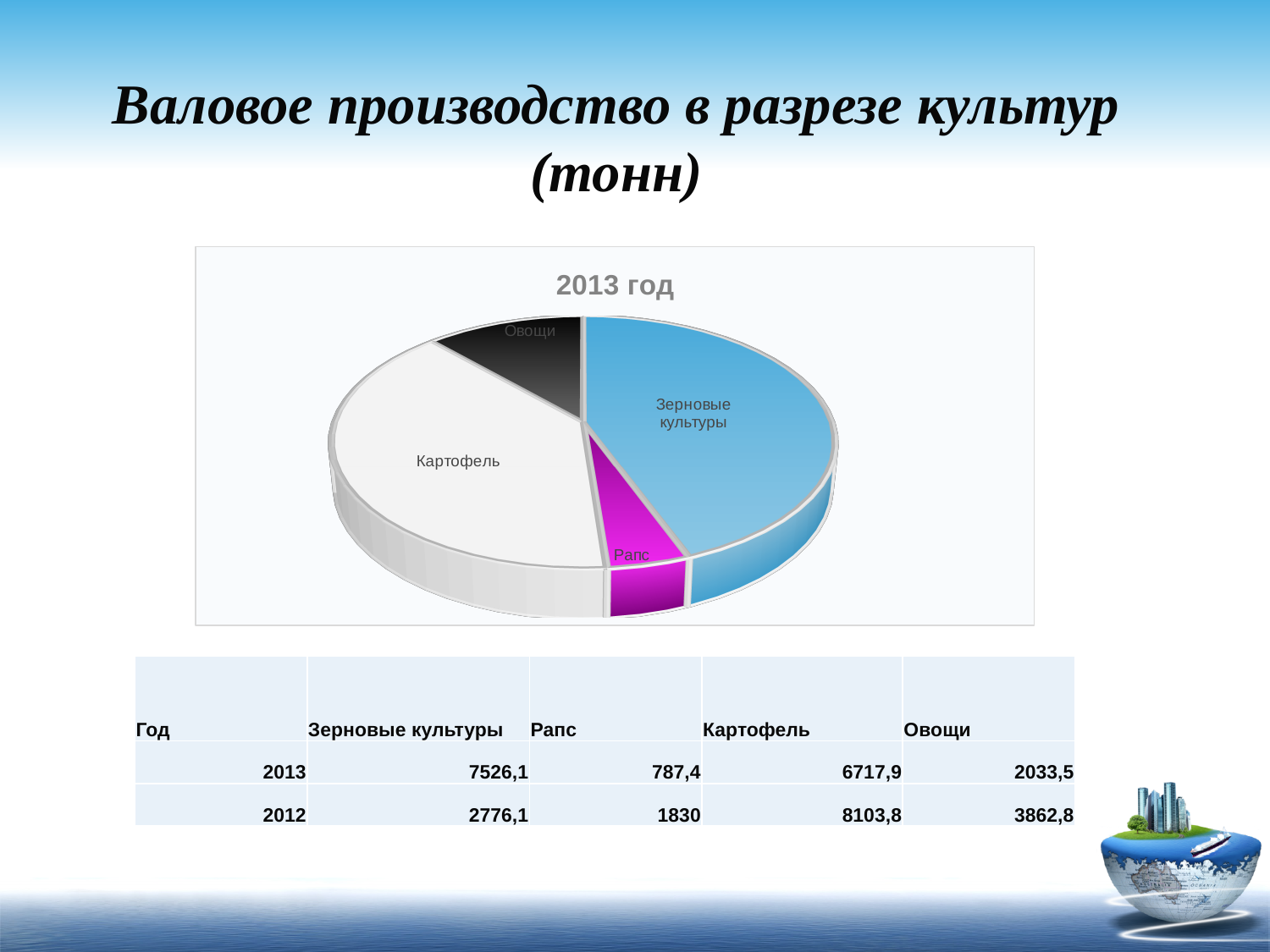
What kind of chart is shown on the slide? pie chart What is the value for Зерновые культуры in 2013, as printed in the table below the chart? 7526,1 Which slice is larger in the pie chart, Картофель or Овощи? Картофель Using the 2013 values printed in the table, how much larger is Зерновые культуры than Картофель? 808,2 What is the value for Овощи in 2013, as printed in the table below the chart? 2033,5 Which category has the smallest slice in the pie chart? Рапс Which category has the largest slice in the pie chart? Зерновые культуры What is the title of the pie chart? 2013 год What is the value for Рапс in 2013, as printed in the table below the chart? 787,4 What colour is the Рапс slice in the pie chart? magenta How many slices does the pie chart have? 4 Which slice is larger in the pie chart, Овощи or Рапс? Овощи